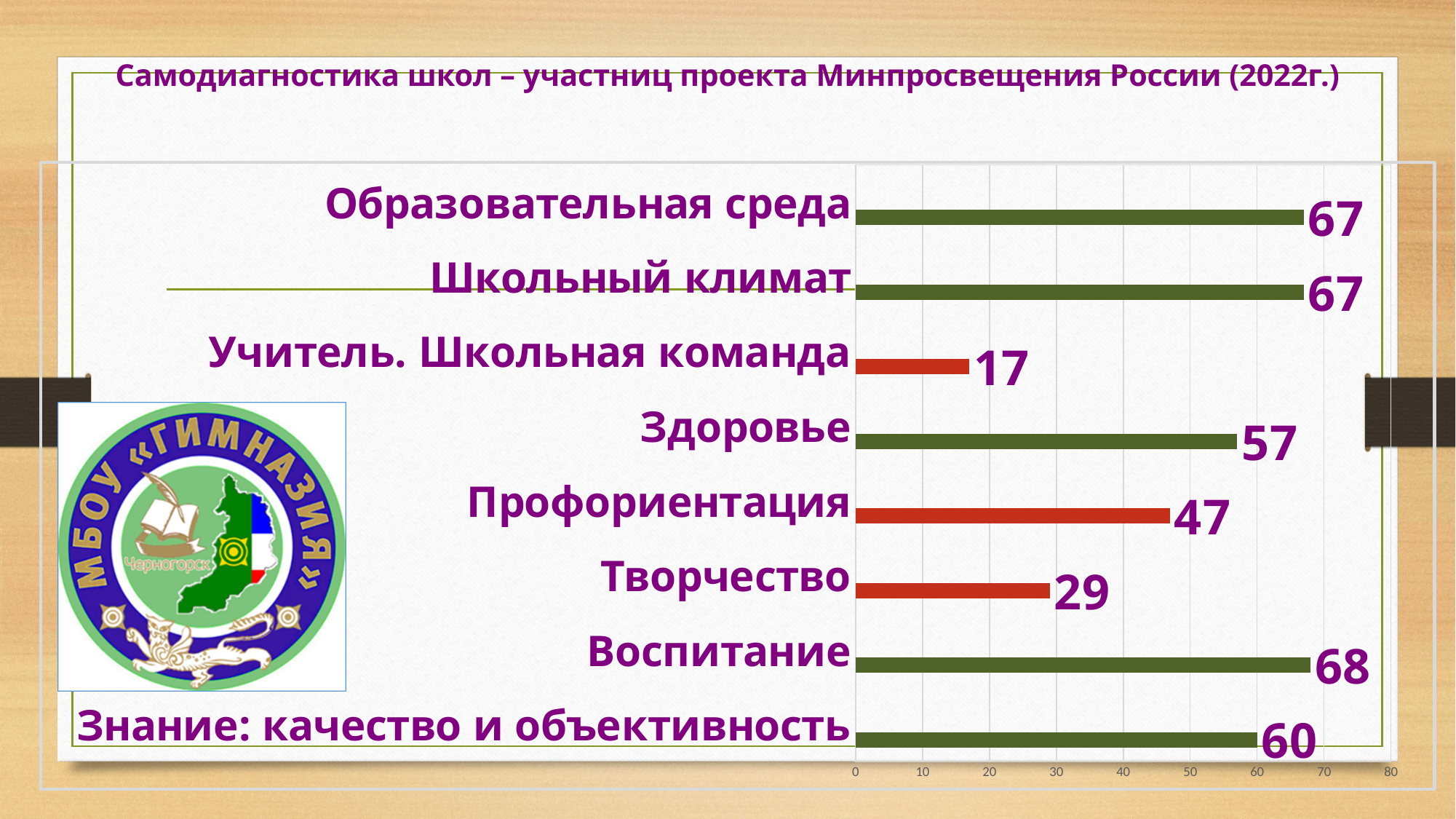
What is the value for Воспитание? 68 Which is larger, the value for Профориентация or the value for Здоровье? Здоровье What colour are the bars for Учитель. Школьная команда, Профориентация and Творчество? red Which category has the highest value? Воспитание Is the value for Творчество greater or less than 40? less What is the value for Профориентация? 47 What is the value for Знание: качество и объективность? 60 How many categories are shown in the chart? 8 What is the difference between the values for Здоровье and Творчество? 28 Which category has the lowest value? Учитель. Школьная команда What kind of chart is shown on the slide? bar chart What is the value for Учитель. Школьная команда? 17